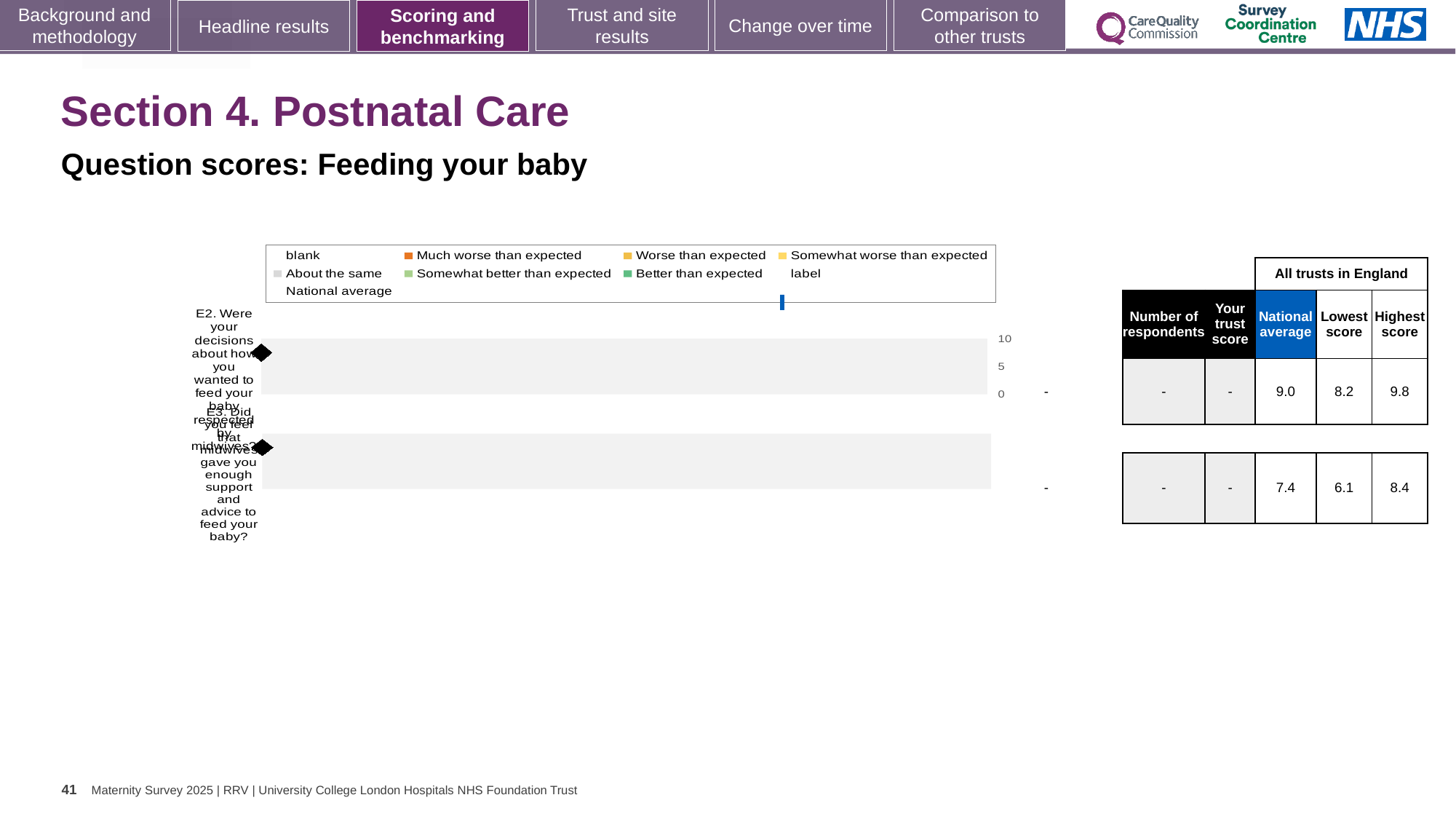
According to the table, what is the difference between the national averages of E2 and E3? 1.6 According to the table, what is the difference between the highest score and the lowest score for question E2? 1.6 How many questions (categories) are listed on the chart's vertical axis? 2 In the table to the right of the chart, what is the lowest score across all trusts in England for question E3? 6.1 What kind of chart is shown on the slide? bar chart In the table to the right of the chart, what is the national average for question E3 (midwives gave you enough support and advice to feed your baby)? 7.4 According to the table, which question has the higher national average, E2 or E3? E2 What colour is the legend marker for 'Much worse than expected'? orange What is shown in the 'Your trust score' column of the table for question E2? - What is the highest tick value shown on the chart's numeric axis? 10 In the table to the right of the chart, what is the highest score across all trusts in England for question E2? 9.8 In the table to the right of the chart, what is the national average for question E2 (decisions about how you wanted to feed your baby respected by midwives)? 9.0